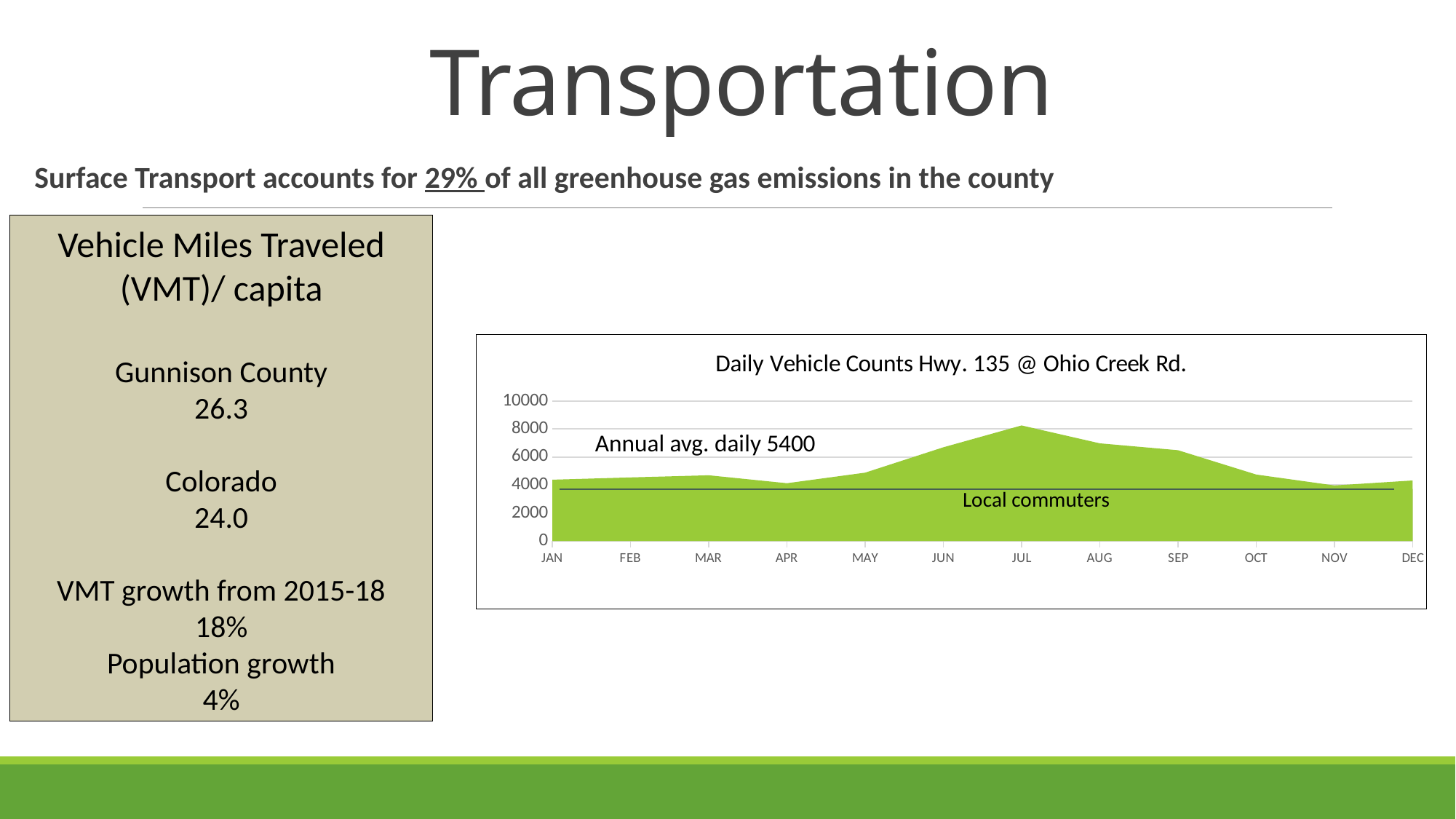
How many months are shown along the x axis of the chart? 12 Do the daily vehicle counts rise or fall from JUL to NOV? fall What kind of chart is shown on the slide? area chart Is the daily vehicle count for JAN greater or less than 6000? less What is the title of the chart? Daily Vehicle Counts Hwy. 135 @ Ohio Creek Rd. Is the daily vehicle count for APR greater or less than 6000? less Is the daily vehicle count for JUL greater or less than 6000? greater Do the daily vehicle counts rise or fall from APR to JUL? rise Which month has a higher daily vehicle count, JUL or JAN? JUL In which month is the daily vehicle count highest? JUL What annual average daily vehicle count is annotated on the chart? 5400